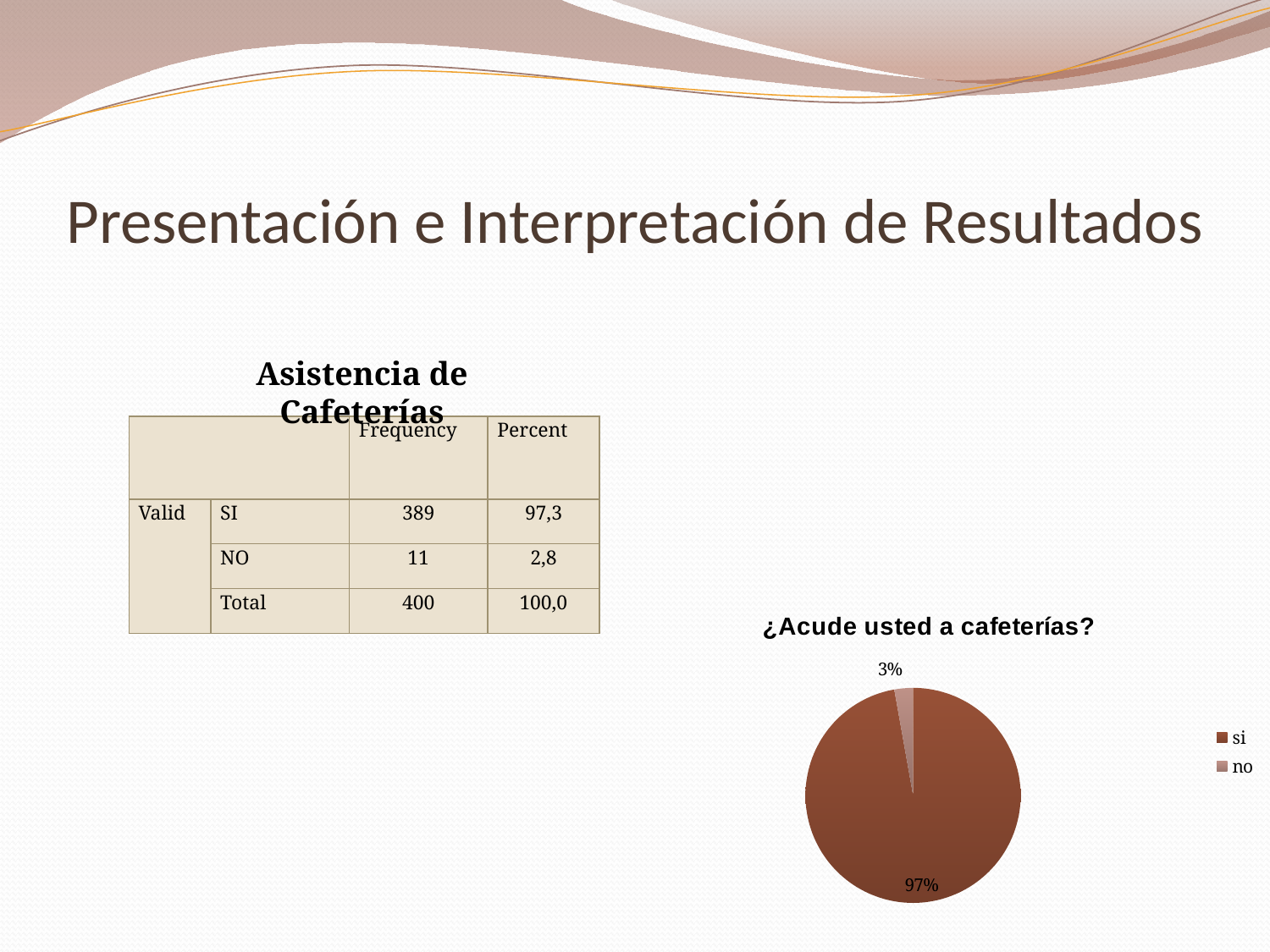
Which slice of the pie chart is the smallest? no Which slice of the pie chart is the largest? si Which legend entry is shown in the lighter colour in the pie chart? no What share of the pie does the 'si' slice represent? 97% What kind of chart is shown on the slide? pie chart What is the difference in percentage points between the 'si' and 'no' slices? 94% Is the 'si' slice larger or smaller than the 'no' slice? larger What is the title of the pie chart? ¿Acude usted a cafeterías? How many slices does the pie chart have? 2 What share of the pie does the 'no' slice represent? 3% How many entries does the legend of the pie chart list? 2